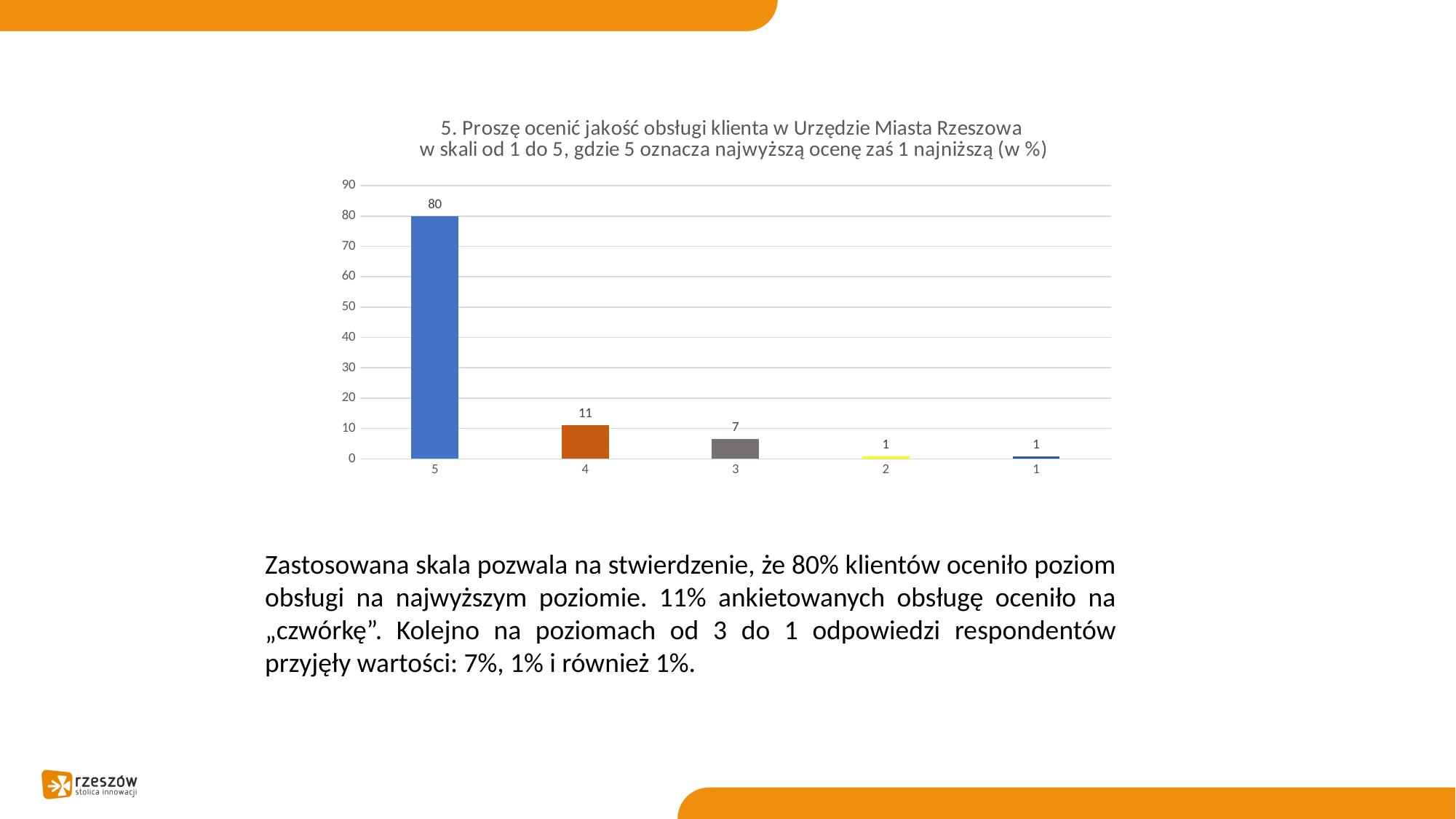
How many rating categories are shown on the x axis? 5 What kind of chart is shown on the slide? bar chart What colour is the bar for rating 5? blue What value is shown for rating 4? 11 What value is shown for rating 5? 80 Is the value for rating 5 greater or less than 70? greater What value is shown for rating 2? 1 What is the difference between the values for rating 4 and rating 3? 4 What is the difference between the values for rating 5 and rating 4? 69 Which is larger, the value for rating 3 or the value for rating 4? rating 4 Which rating category has the highest value? 5 What value is shown for rating 3? 7